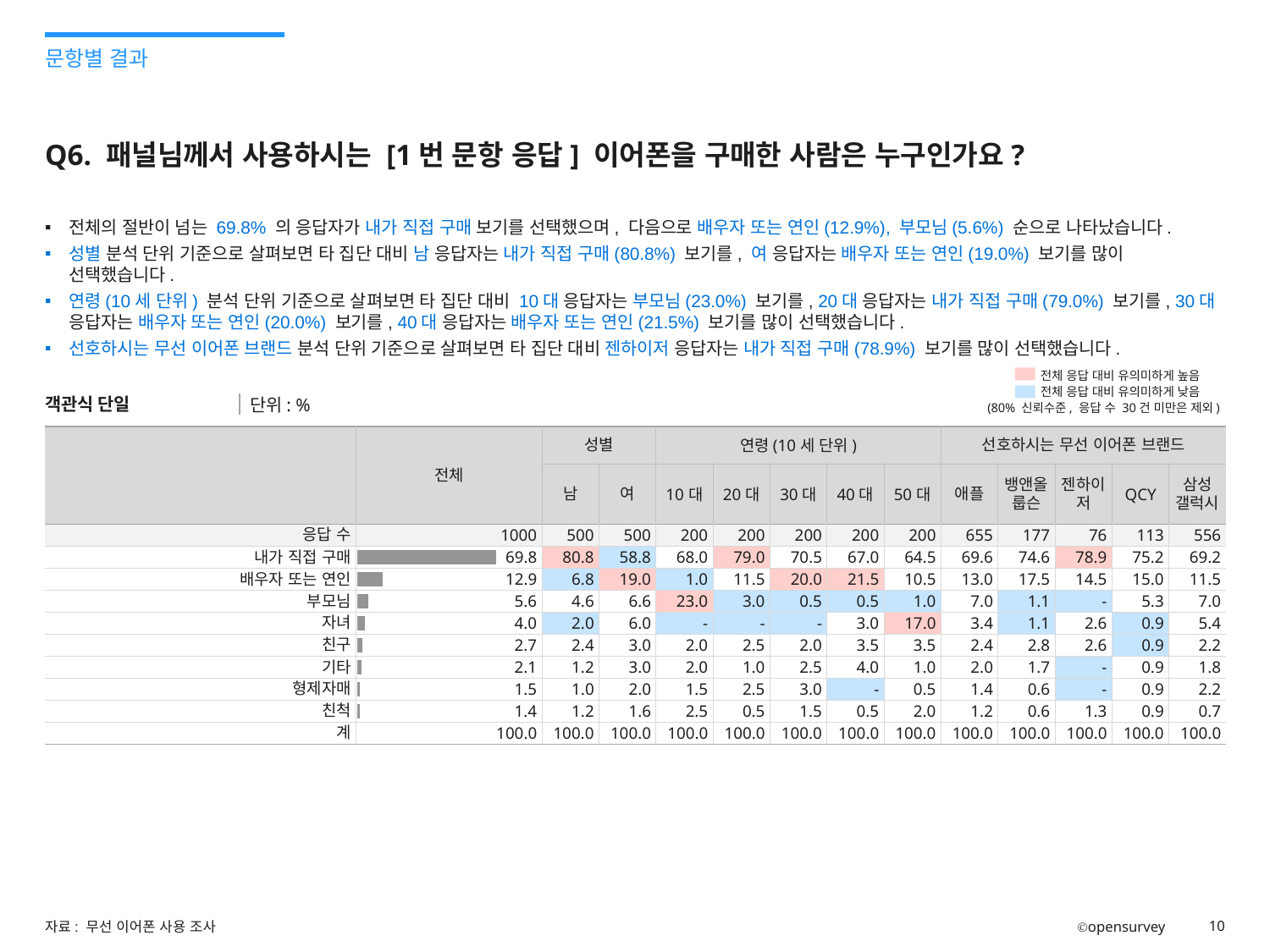
What is the total of the overall (전체) column as shown in the 계 row? 100.0 Which category has the highest overall (전체) value in the bar chart? 내가 직접 구매 What is the difference between the overall values for 내가 직접 구매 and 배우자 또는 연인? 56.9 What is the unit of the values shown in the chart? % How many response categories are shown as bars in the chart (excluding 응답 수 and 계)? 8 What is the overall (전체) value for 부모님? 5.6 What is the overall (전체) value for 배우자 또는 연인? 12.9 What kind of chart is shown in the 전체 column? bar chart Which has a larger overall value, 자녀 or 친구? 자녀 Which category has the lowest overall (전체) value in the bar chart? 친척 What is the difference between the overall values for 부모님 and 자녀? 1.6 What is the overall (전체) value for 내가 직접 구매? 69.8